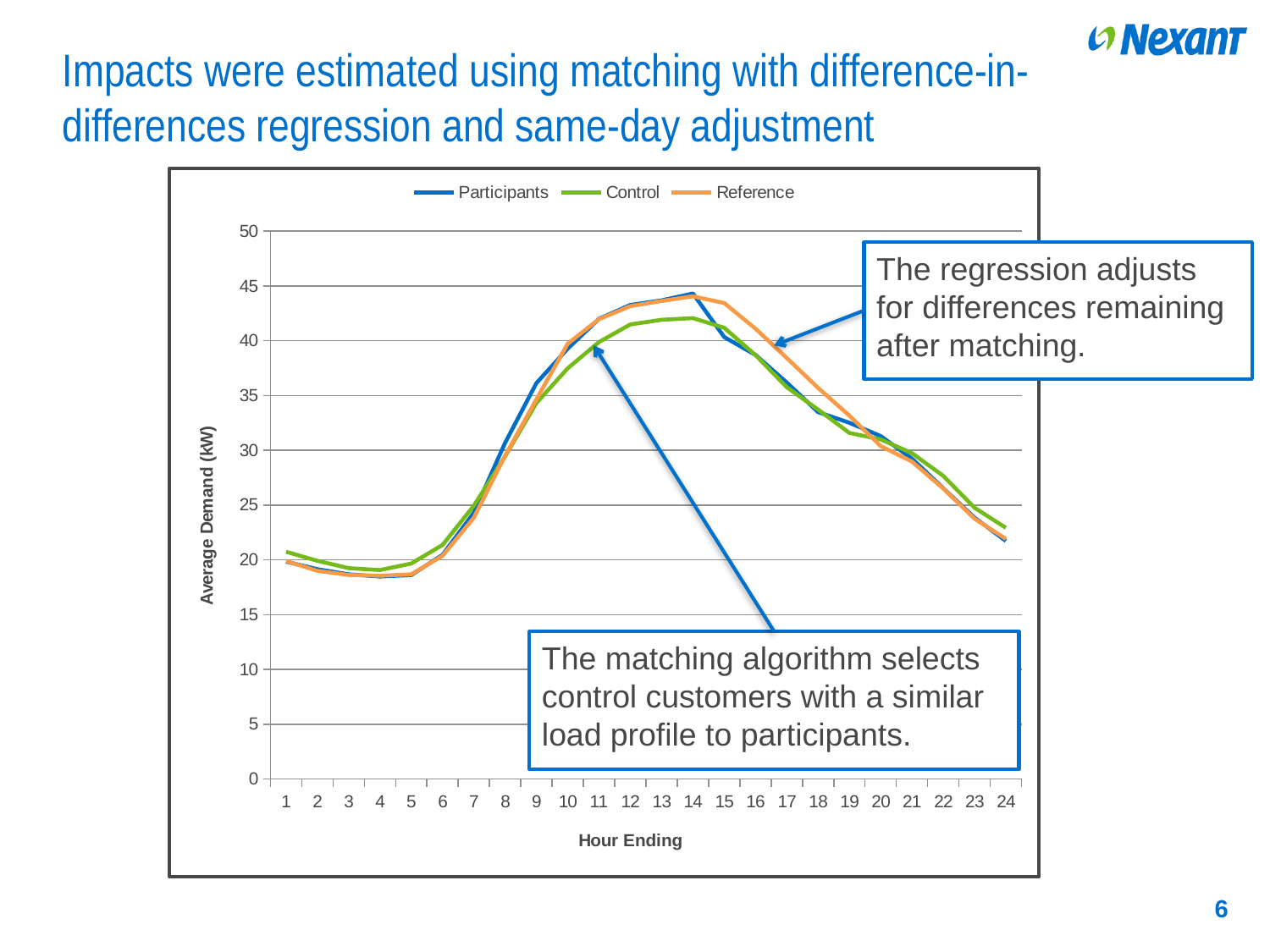
What is the title of the chart's vertical axis? Average Demand (kW) Is the Participants value at hour ending 24 greater or less than 25? less How many hours are plotted along the x axis of the chart? 24 What kind of chart is shown on the slide? line chart How many series does the chart legend list? 3 At hour ending 14, which series is larger, Participants or Control? Participants At which hour ending does the Participants series reach its highest value? 14 Is the Control value at hour ending 4 greater or less than 20? less Which colour is used for the Reference series in the chart? orange Is the Participants value at hour ending 14 greater or less than 40? greater Do the Participants values rise or fall from hour ending 14 to hour ending 24? fall